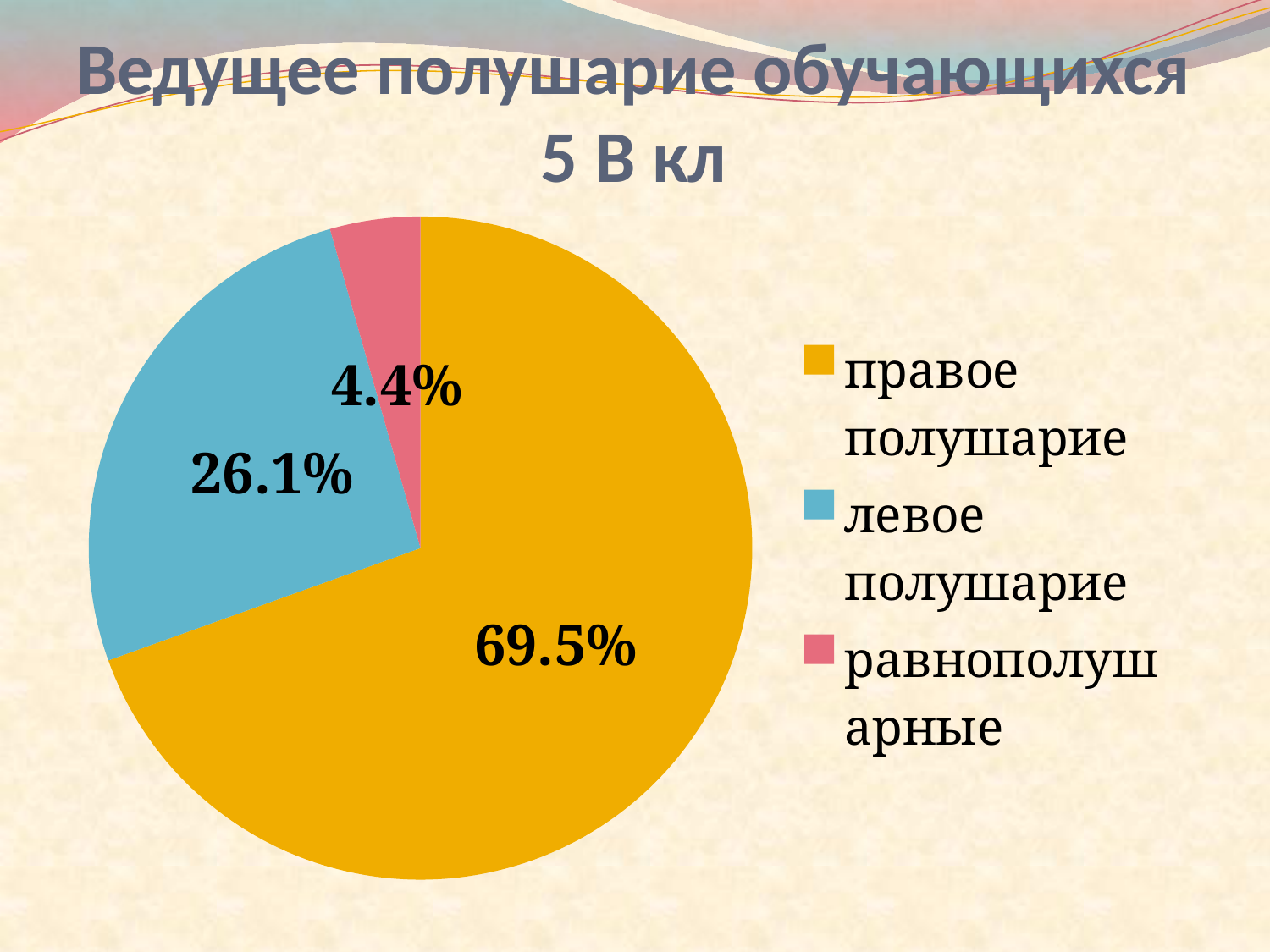
What kind of chart is shown on the slide? pie chart Which category has the largest slice of the pie? правое полушарие What is the share for правое полушарие? 69.5% What is the difference between the shares for правое полушарие and левое полушарие? 43.4% What is the share for левое полушарие? 26.1% Which category has the smallest slice of the pie? равнополушарные What is the difference between the shares for левое полушарие and равнополушарные? 21.7% How many slices does the pie chart have? 3 What is the title of the chart on the slide? Ведущее полушарие обучающихся 5 В кл Which is larger, the share for левое полушарие or the share for равнополушарные? левое полушарие What is the share for равнополушарные? 4.4% What colour is the slice for левое полушарие? blue